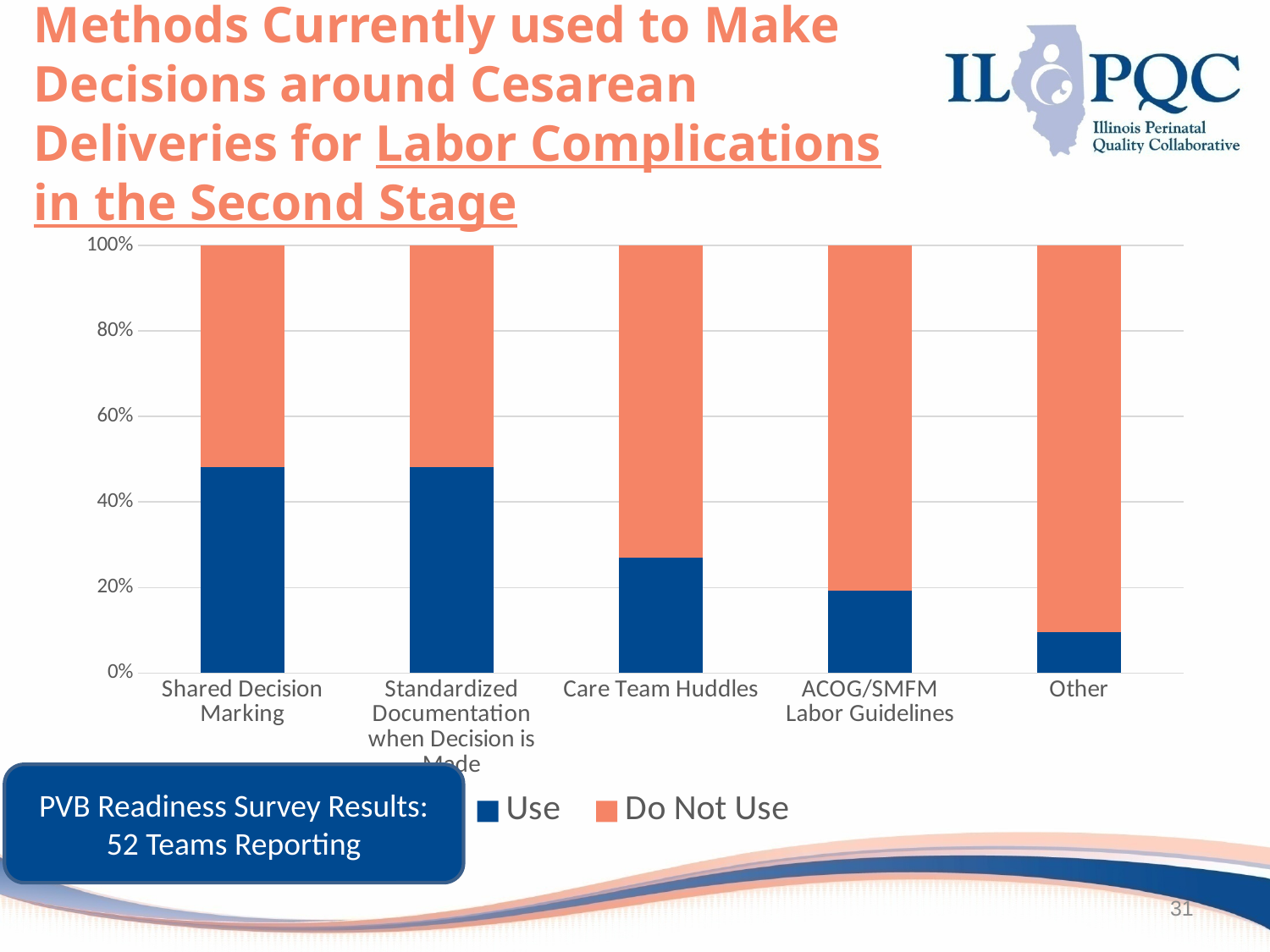
Is the 'Use' value for Care Team Huddles greater or less than 20%? greater What is the total height of each stacked bar in the chart? 100% Which has a larger 'Use' share: Care Team Huddles or Other? Care Team Huddles Is the 'Use' value for Other greater or less than 20%? less Does the 'Use' share rise or fall moving from left to right across the categories? fall What are the two series named in the chart legend? Use, Do Not Use Which category has the lowest 'Use' share? Other How many categories (methods) are shown on the x axis of the chart? 5 How many series does the chart legend list? 2 What kind of chart is shown on the slide? stacked bar chart Is the 'Use' value for Shared Decision Marking greater or less than 40%? greater